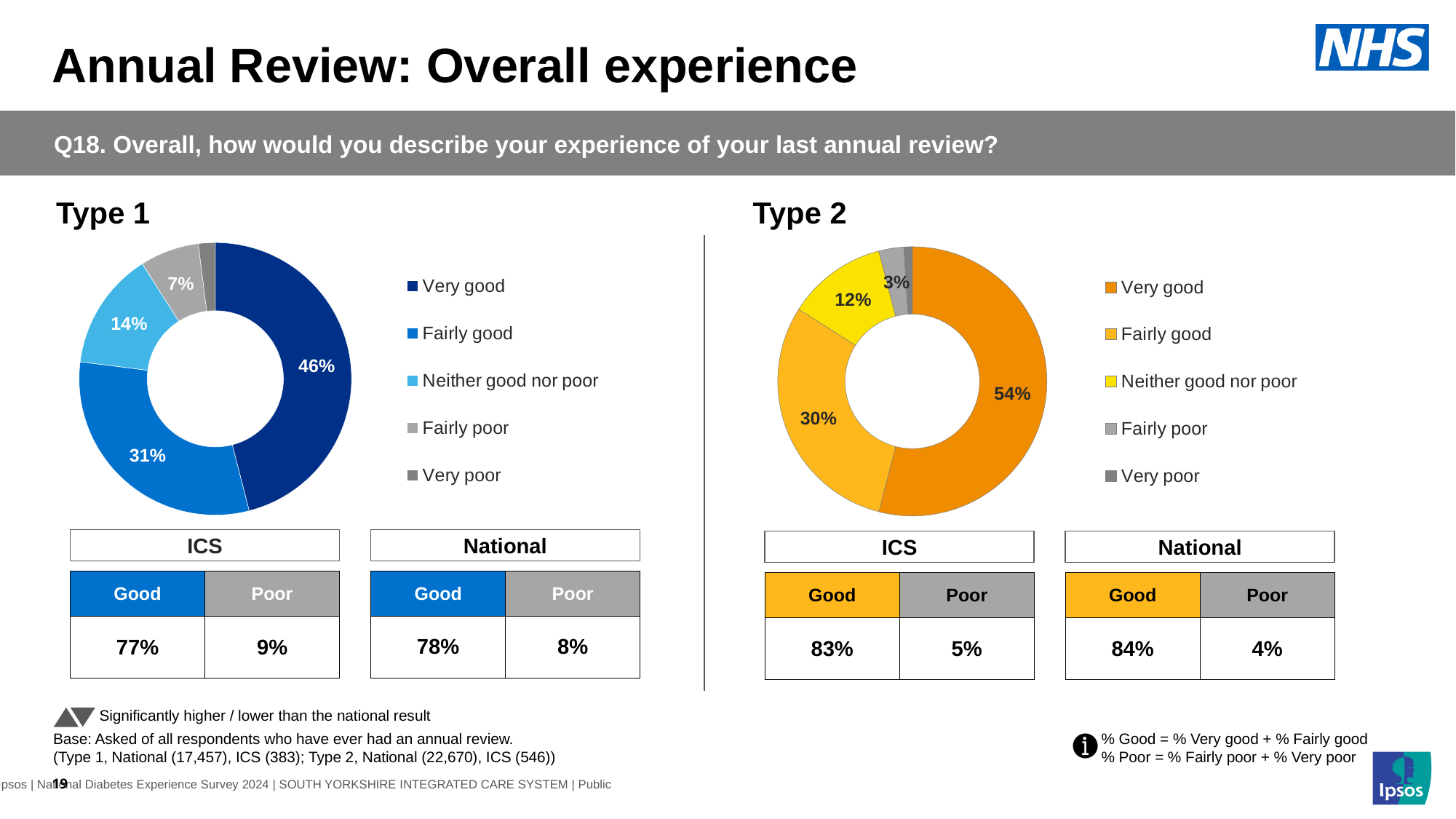
In the Type 2 chart, what percentage of respondents said their experience was Fairly good? 30% In the Type 2 chart, which response category has the largest share? Very good What kind of chart is used to show the Type 2 results? Donut (pie) chart In the Type 2 chart, what colour represents Neither good nor poor? Yellow In the Type 1 chart, what is the combined share of Very good and Fairly good? 77% In the Type 1 chart, what percentage of respondents said their experience was Very good? 46% How many response categories does the legend of the Type 1 chart list? 5 Which is larger: the Fairly good share in the Type 1 chart or the Fairly good share in the Type 2 chart? Type 1 (31%) In the Type 1 chart, what percentage said Neither good nor poor? 14% In the Type 1 chart, which labelled response category has the smallest share? Fairly poor What is the difference between the Very good share in the Type 2 chart and the Very good share in the Type 1 chart? 8% In the Type 2 chart, what percentage said Fairly poor? 3%